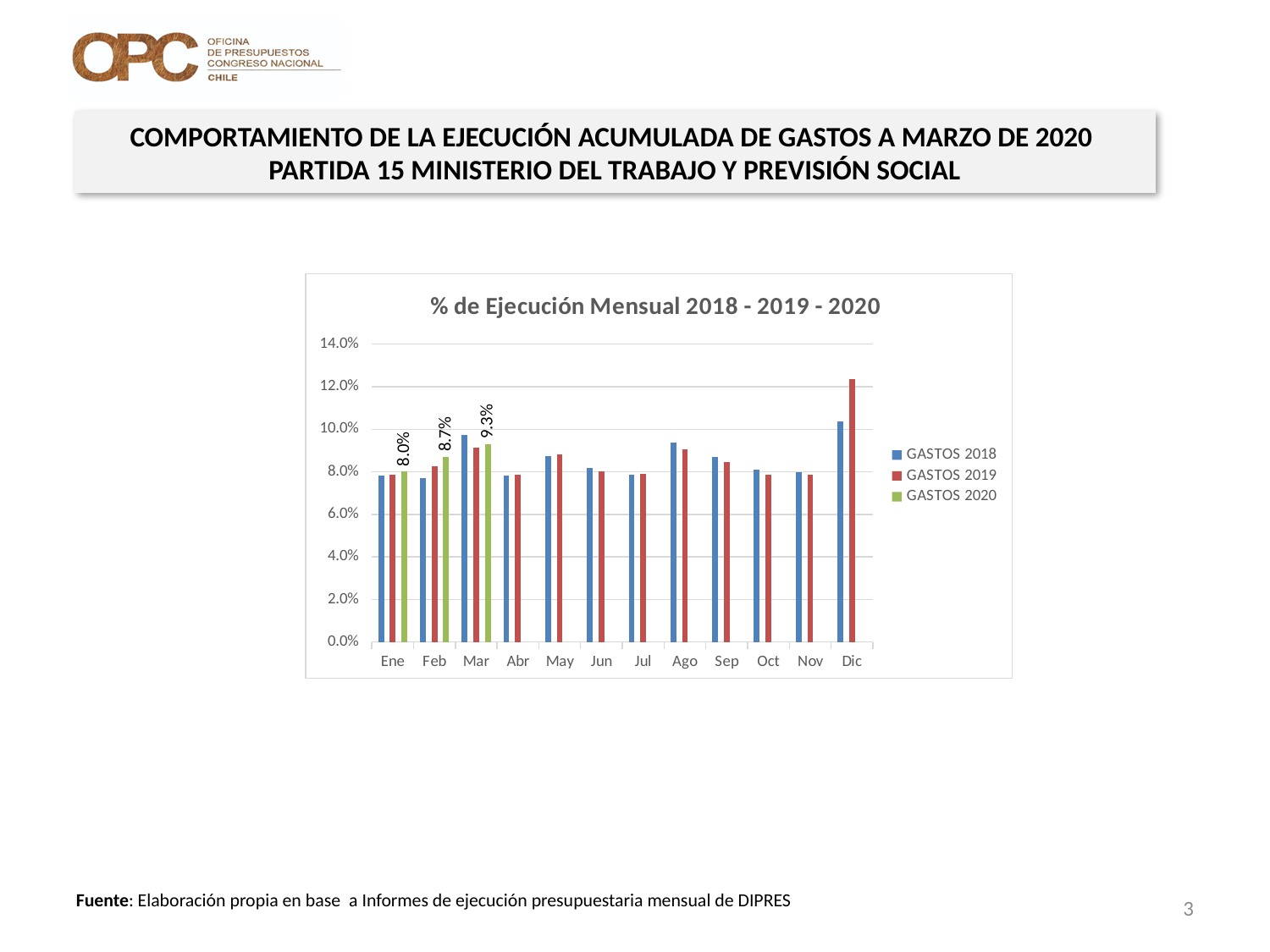
How many months are shown on the x axis? 12 Which month has the highest value for GASTOS 2020? Mar Do the GASTOS 2020 values rise or fall from Ene to Mar? rise What is the value for GASTOS 2020 in Mar? 9.3% What is the value for GASTOS 2020 in Ene? 8.0% In Dic, which is larger: GASTOS 2018 or GASTOS 2019? GASTOS 2019 What kind of chart is shown on the slide? bar chart What is the value for GASTOS 2020 in Feb? 8.7% Which month has the lowest value for GASTOS 2020? Ene How many series does the legend list? 3 What is the difference between the GASTOS 2020 values for Mar and Ene? 1.3% Is the value for GASTOS 2019 in Dic greater or less than 12.0%? greater